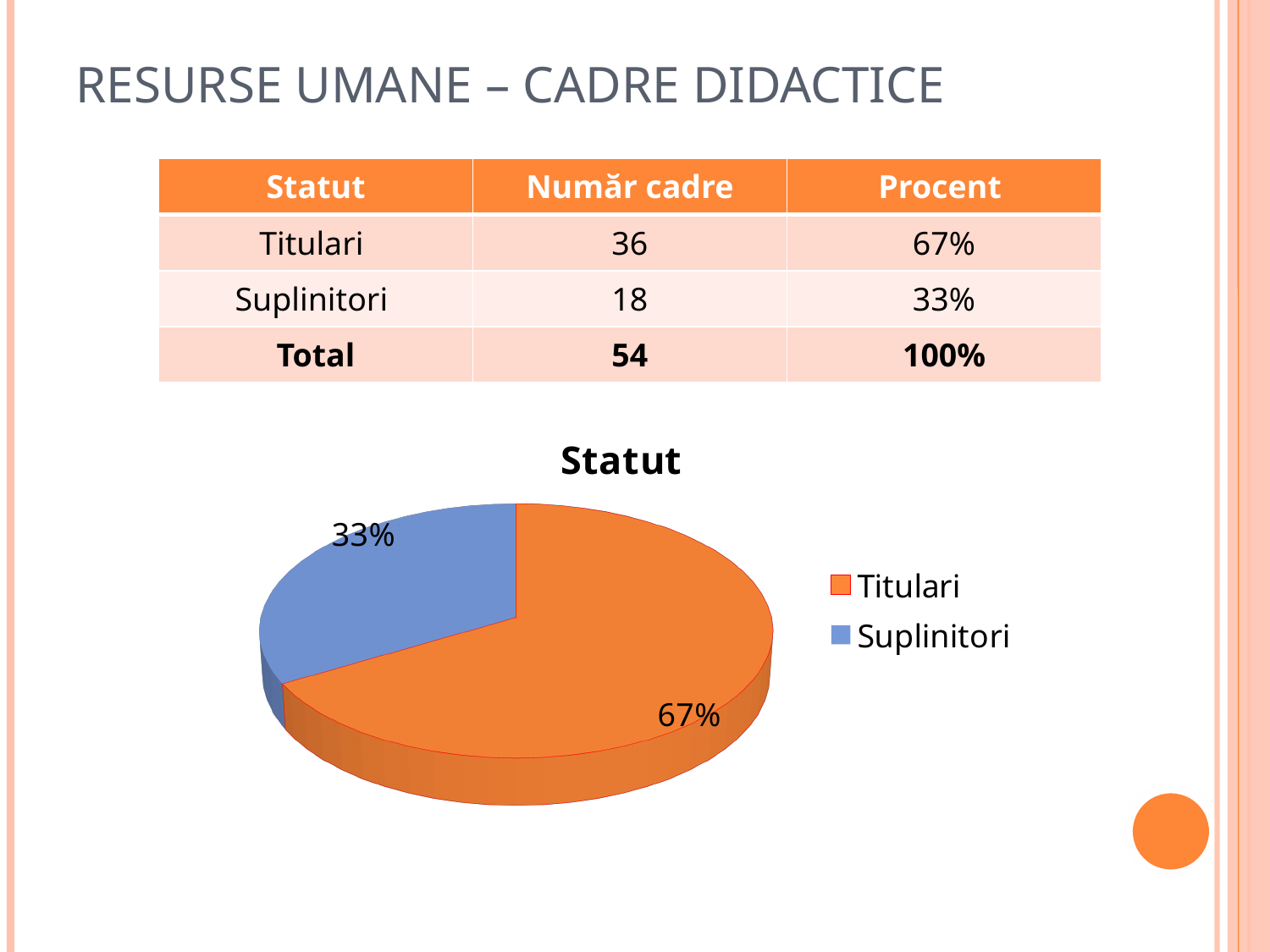
Which category has the smallest slice of the pie? Suplinitori What share of the pie does Suplinitori represent? 33% How many categories does the pie chart show? 2 What is the difference in percentage points between the Titulari and Suplinitori slices? 34 percentage points What is the title of the chart? Statut What share of the pie does Titulari represent? 67% Which slice is larger, Titulari or Suplinitori? Titulari How many entries does the legend list? 2 Which category has the largest slice of the pie? Titulari What colour is the Suplinitori slice in the pie chart? blue What type of chart is shown on the slide? pie chart